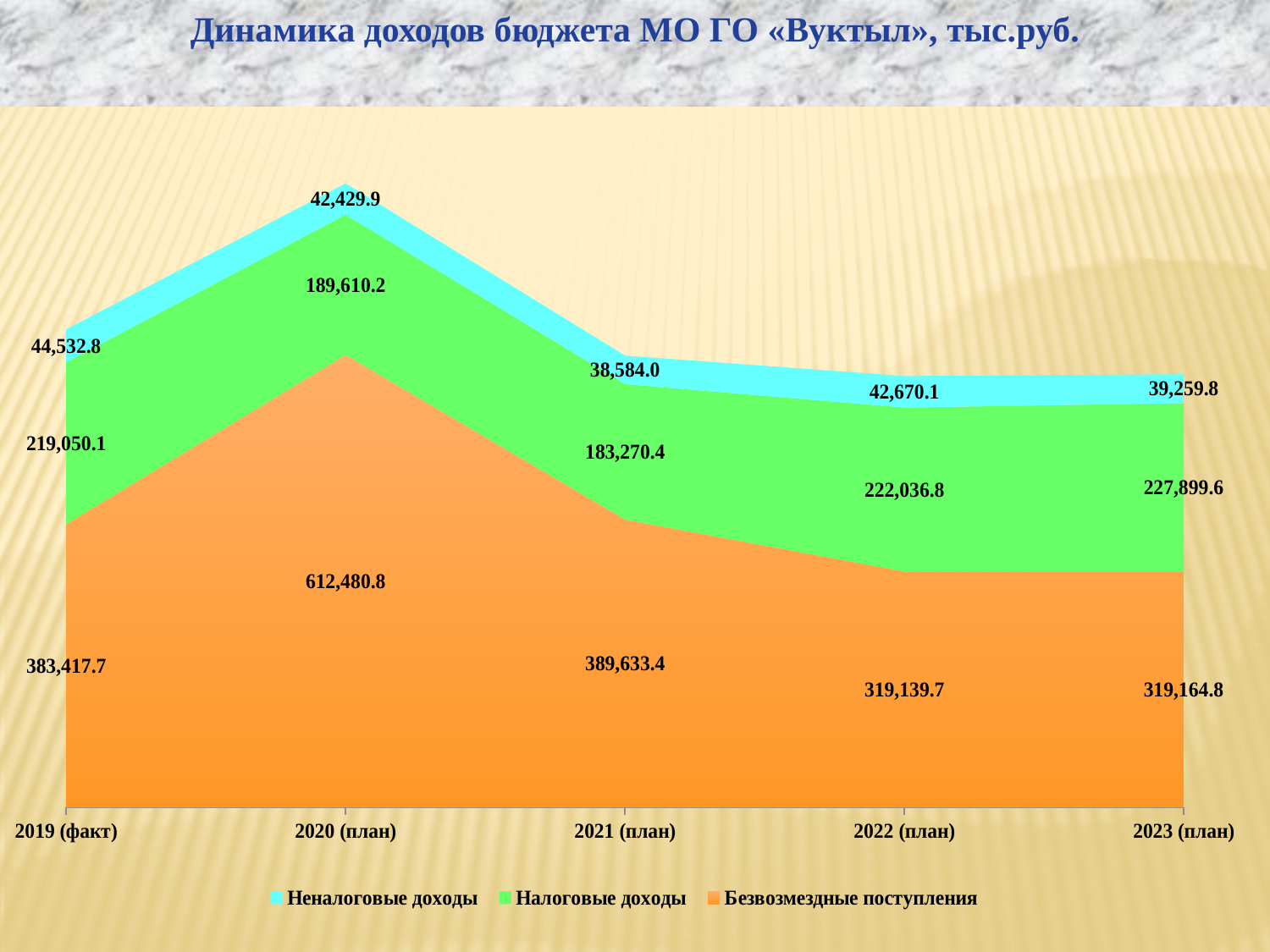
What is the value of Неналоговые доходы for 2019 (факт)? 44,532.8 Which is larger: Налоговые доходы in 2019 (факт) or in 2021 (план)? 2019 (факт) What is the difference between Безвозмездные поступления in 2020 (план) and 2021 (план)? 222,847.4 What is the total of all three series for 2020 (план)? 844,520.9 How many years are shown on the x axis? 5 What is the value of Налоговые доходы for 2023 (план)? 227,899.6 In which year is Неналоговые доходы lowest? 2021 (план) In which year is Безвозмездные поступления highest? 2020 (план) Does Неналоговые доходы rise or fall from 2019 (факт) to 2021 (план)? Fall What is the value of Безвозмездные поступления for 2020 (план)? 612,480.8 What kind of chart is this? Stacked area chart How many series does the legend list? 3